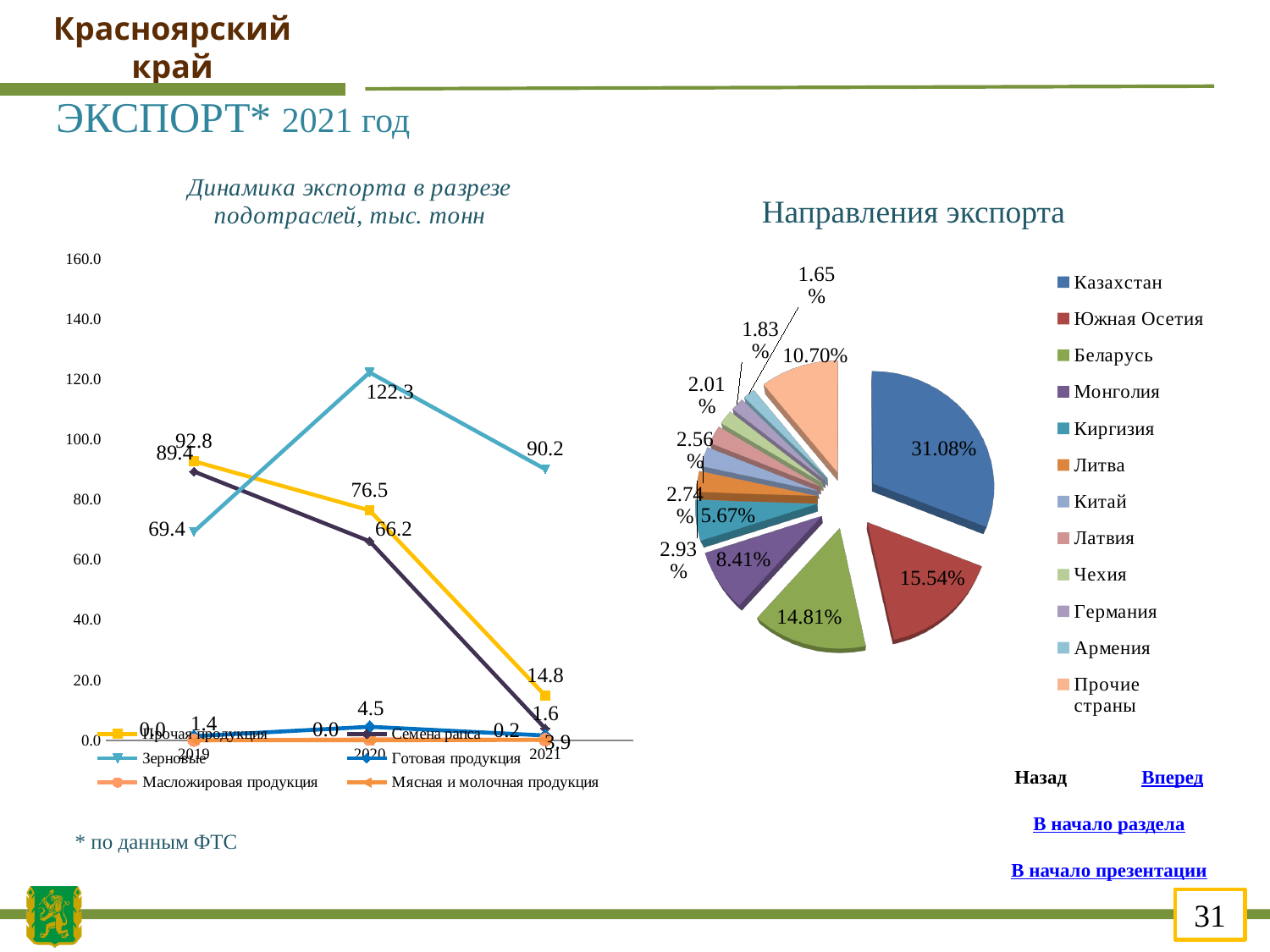
What type of chart is 'Динамика экспорта в разрезе подотраслей'? Line chart In the line chart 'Динамика экспорта в разрезе подотраслей', what is the value for Зерновые in 2020? 122.3 In the pie chart 'Направления экспорта', what share does Казахстан have? 31.08% In the line chart 'Динамика экспорта в разрезе подотраслей', by how much did Зерновые decrease from 2020 to 2021? 32.1 In the pie chart 'Направления экспорта', which share is larger: Киргизия or Монголия? Монголия In the pie chart 'Направления экспорта', which country has the largest share? Казахстан In the pie chart 'Направления экспорта', how many entries does the legend list? 12 In the pie chart 'Направления экспорта', what share does Беларусь have? 14.81% In the pie chart 'Направления экспорта', what share does Монголия have? 8.41% In the line chart 'Динамика экспорта в разрезе подотраслей', what is the value for Зерновые in 2021? 90.2 In the line chart 'Динамика экспорта в разрезе подотраслей', does the value for Прочая продукция rise or fall from 2019 to 2021? Fall